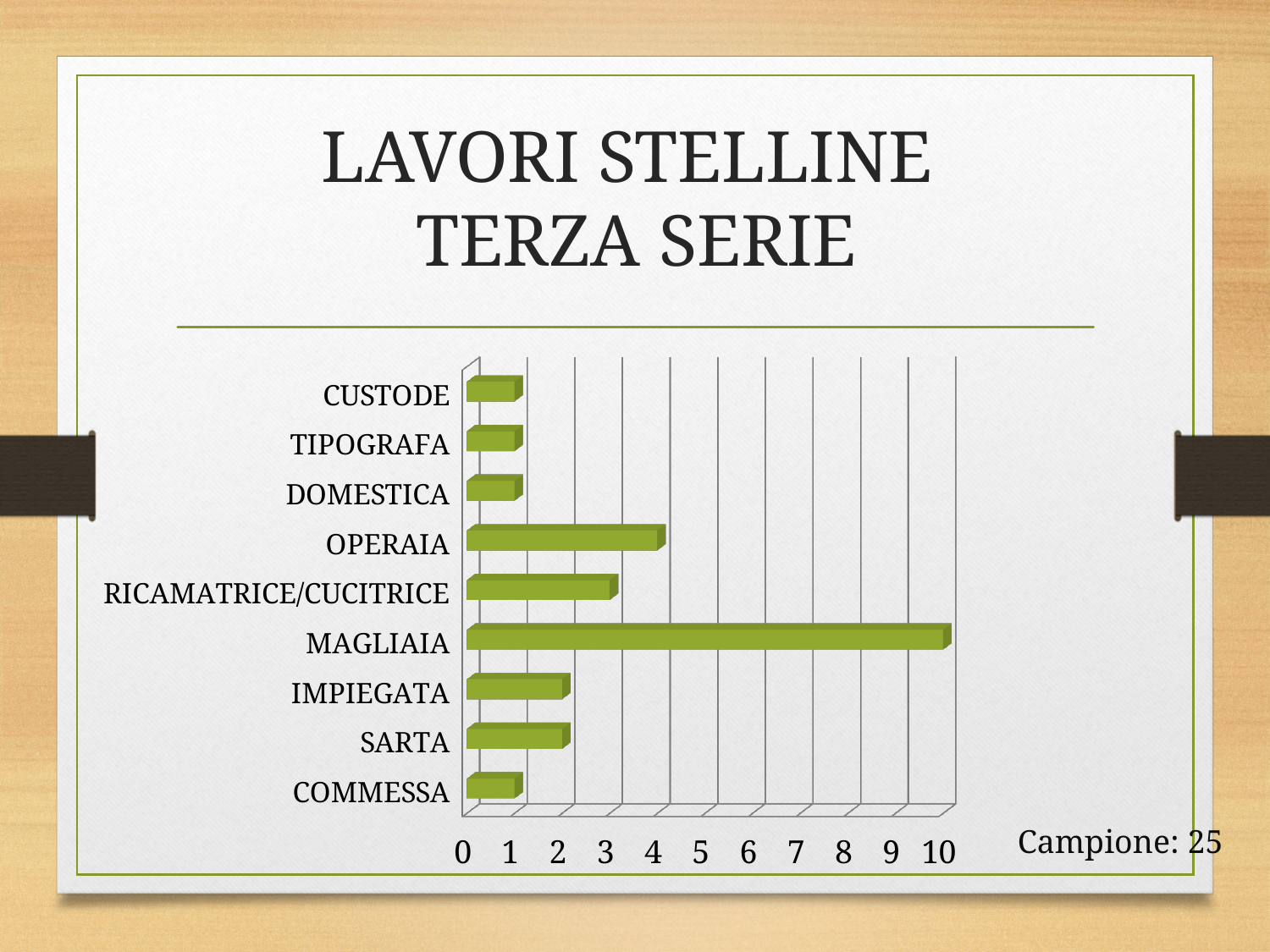
How many categories are shown on the chart? 9 Which category has the highest value? MAGLIAIA Is the value for RICAMATRICE/CUCITRICE greater or less than 5? less Which is larger, the value for OPERAIA or the value for RICAMATRICE/CUCITRICE? OPERAIA Is the value for CUSTODE greater or less than 2? less Is the value for OPERAIA greater or less than 3? greater Which is larger, the value for SARTA or the value for COMMESSA? SARTA What is the title of the slide? LAVORI STELLINE TERZA SERIE What sample size (Campione) is stated on the slide? 25 What kind of chart is shown on the slide? bar chart